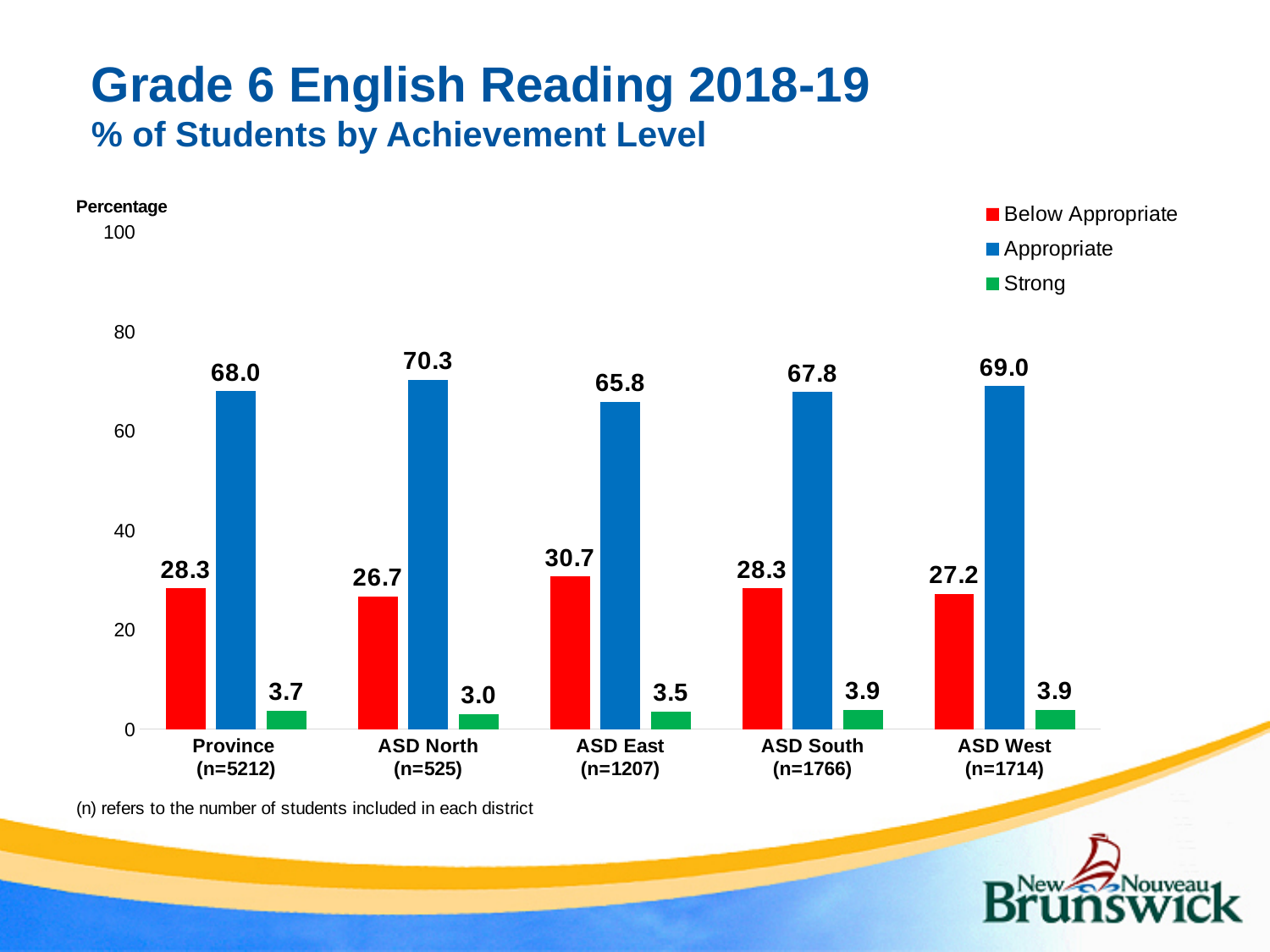
What is the Strong percentage for the Province? 3.7 What colour represents the Strong achievement level in the legend? green What kind of chart is shown on the slide? bar chart What is the difference between the Appropriate percentages for ASD North and ASD East? 4.5 How many series does the legend list? 3 Which is larger, the Below Appropriate percentage for ASD East or for ASD West? ASD East Which district has the highest Appropriate percentage? ASD North What is the Appropriate percentage for ASD North? 70.3 What is the Below Appropriate percentage for ASD East? 30.7 How many categories are shown on the x axis? 5 Is the Appropriate value for ASD South greater or less than 60? greater Which category has the lowest Strong percentage? ASD North